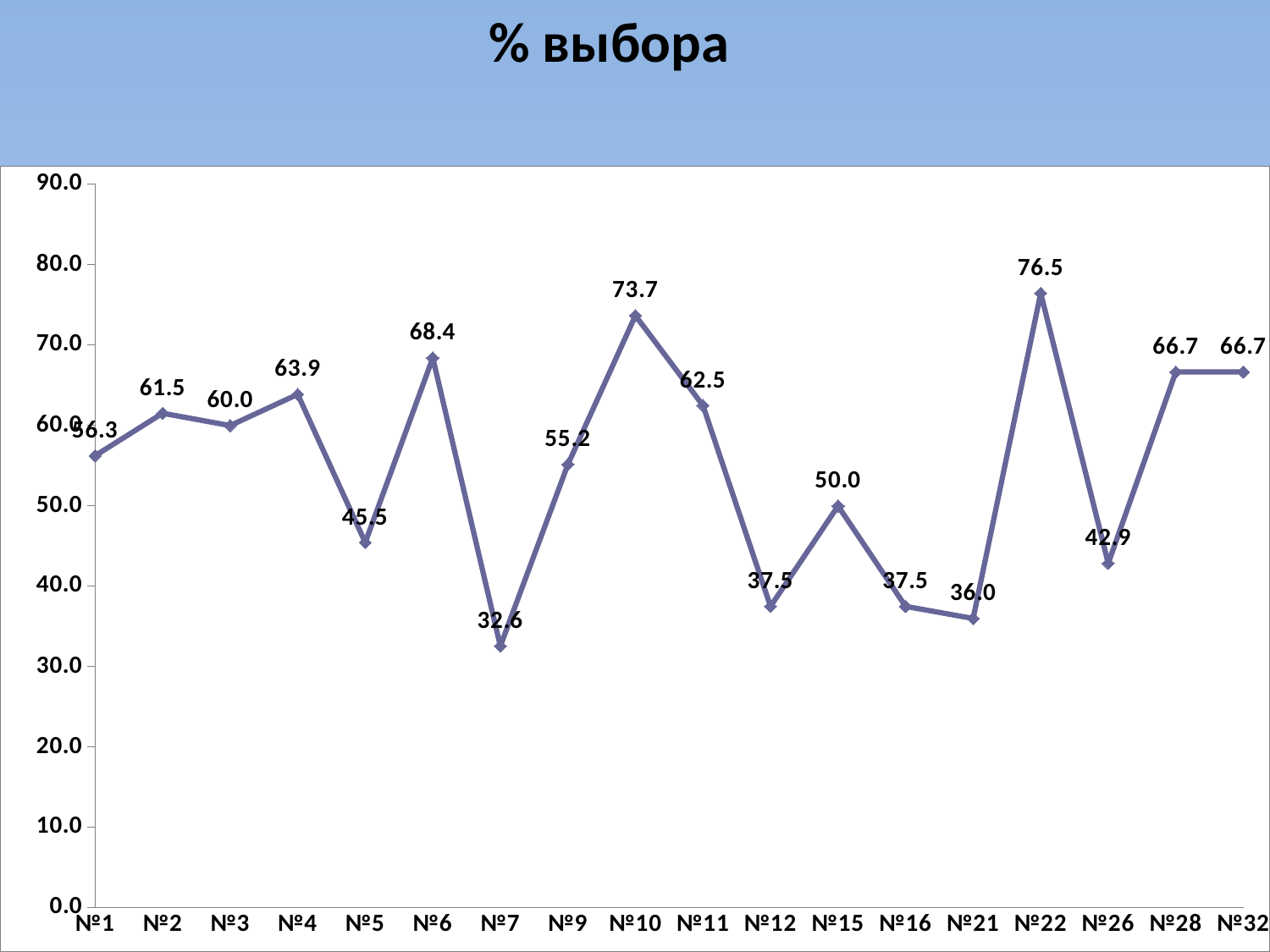
What is the difference between the values for №6 and №5? 22.9 What is the value for №26? 42.9 Which category has the highest value? №22 What kind of chart is shown on the slide? line chart What is the value for №10? 73.7 How many categories are plotted on the x axis? 18 Which category has the lowest value? №7 Which is larger, the value for №4 or the value for №11? №4 What is the value for №7? 32.6 What is the title of the chart? % выбора Is the value for №21 greater or less than 40.0? less What is the difference between the values for №22 and №7? 43.9